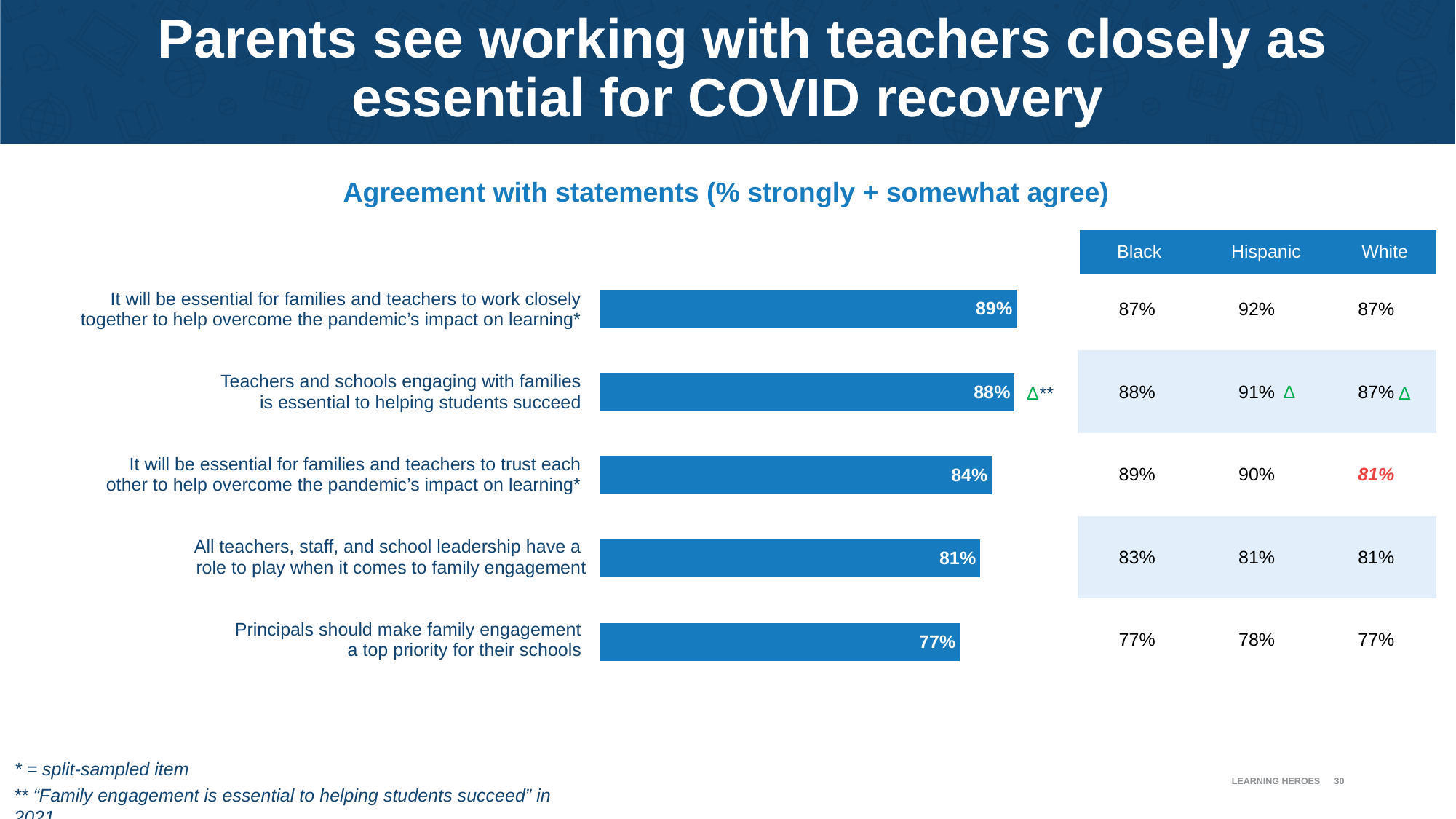
What is the difference in overall agreement between the statement about families and teachers working closely together (89%) and the statement about principals making family engagement a top priority (77%)? 12 percentage points What are the three column headers in the table to the right of the bar chart? Black, Hispanic, White How many statements are shown in the bar chart? 5 Do the bar values rise or fall going from the top statement to the bottom statement? Fall What type of chart is used to show agreement with the statements? Bar chart What is the title of the chart? Agreement with statements (% strongly + somewhat agree) What percentage of parents agree that it will be essential for families and teachers to work closely together to help overcome the pandemic's impact on learning? 89% What percentage of parents agree that all teachers, staff, and school leadership have a role to play when it comes to family engagement? 81% Which statement has the highest overall agreement in the bar chart? It will be essential for families and teachers to work closely together to help overcome the pandemic's impact on learning Which statement has the lowest overall agreement in the bar chart? Principals should make family engagement a top priority for their schools What percentage of parents agree that principals should make family engagement a top priority for their schools? 77% Which has higher overall agreement: the statement that families and teachers must trust each other, or the statement that all teachers, staff, and school leadership have a role to play in family engagement? The statement that families and teachers must trust each other